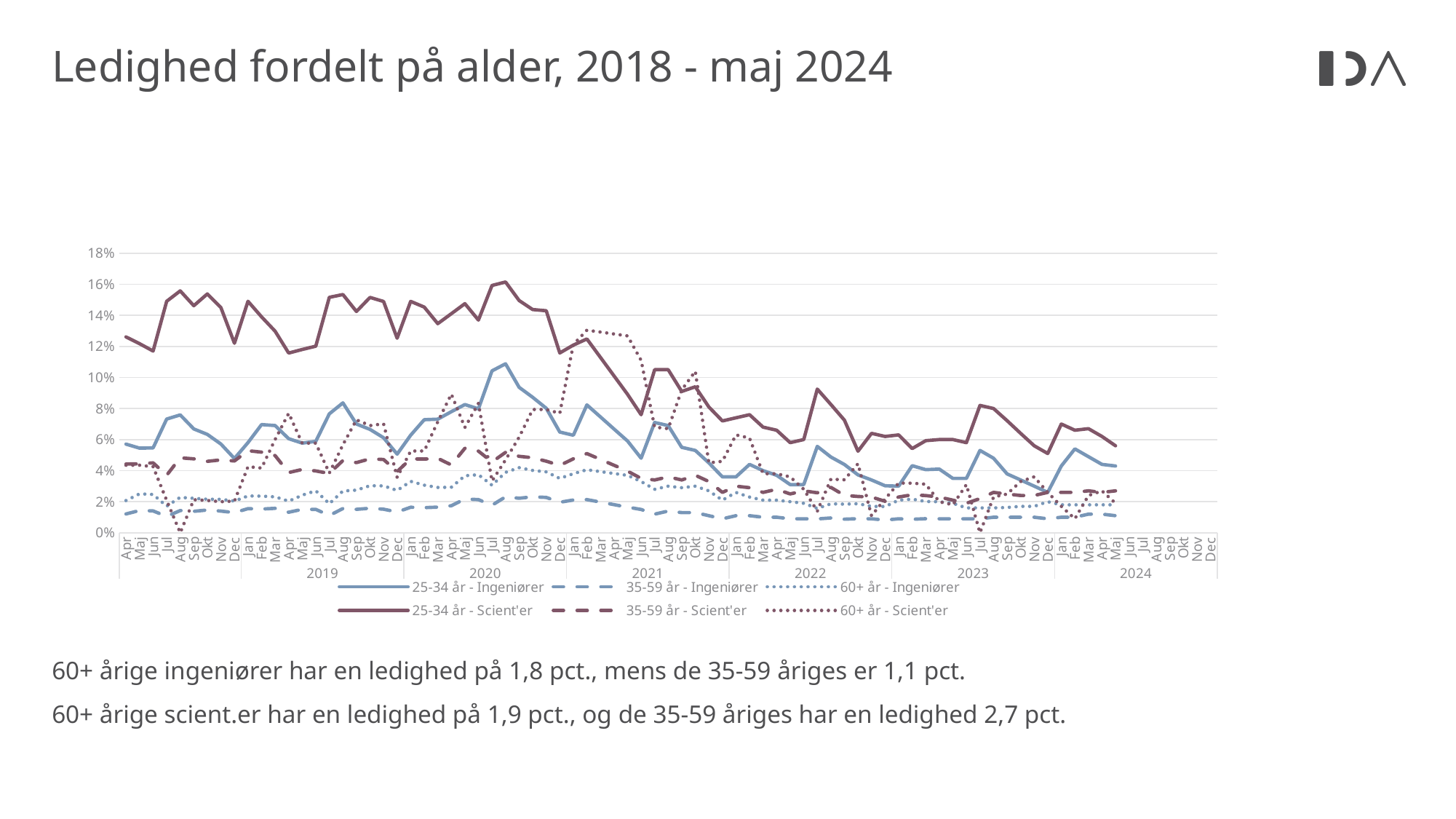
Is the value for 25-34 år - Scient'er in Aug 2020 greater or less than 14%? greater According to the text below the chart, what is the difference between the unemployment rate of 35-59 årige scient.er and 35-59 årige ingeniører? 1,6 pct. Is the value for 25-34 år - Ingeniører in Aug 2020 greater or less than 10%? greater Is the value for 35-59 år - Ingeniører in Aug 2020 greater or less than 4%? less Which series has the highest values across the chart? 25-34 år - Scient'er According to the text below the chart, what is the unemployment rate for 60+ årige ingeniører? 1,8 pct. Does the 25-34 år - Scient'er series rise or fall from early 2021 to 2024? fall What is the highest value shown on the vertical axis? 18% How many series does the legend list? 6 What kind of chart is shown on the slide? line chart What is the title of the chart? Ledighed fordelt på alder, 2018 - maj 2024 According to the text below the chart, what is the unemployment rate for 35-59 årige scient.er? 2,7 pct.